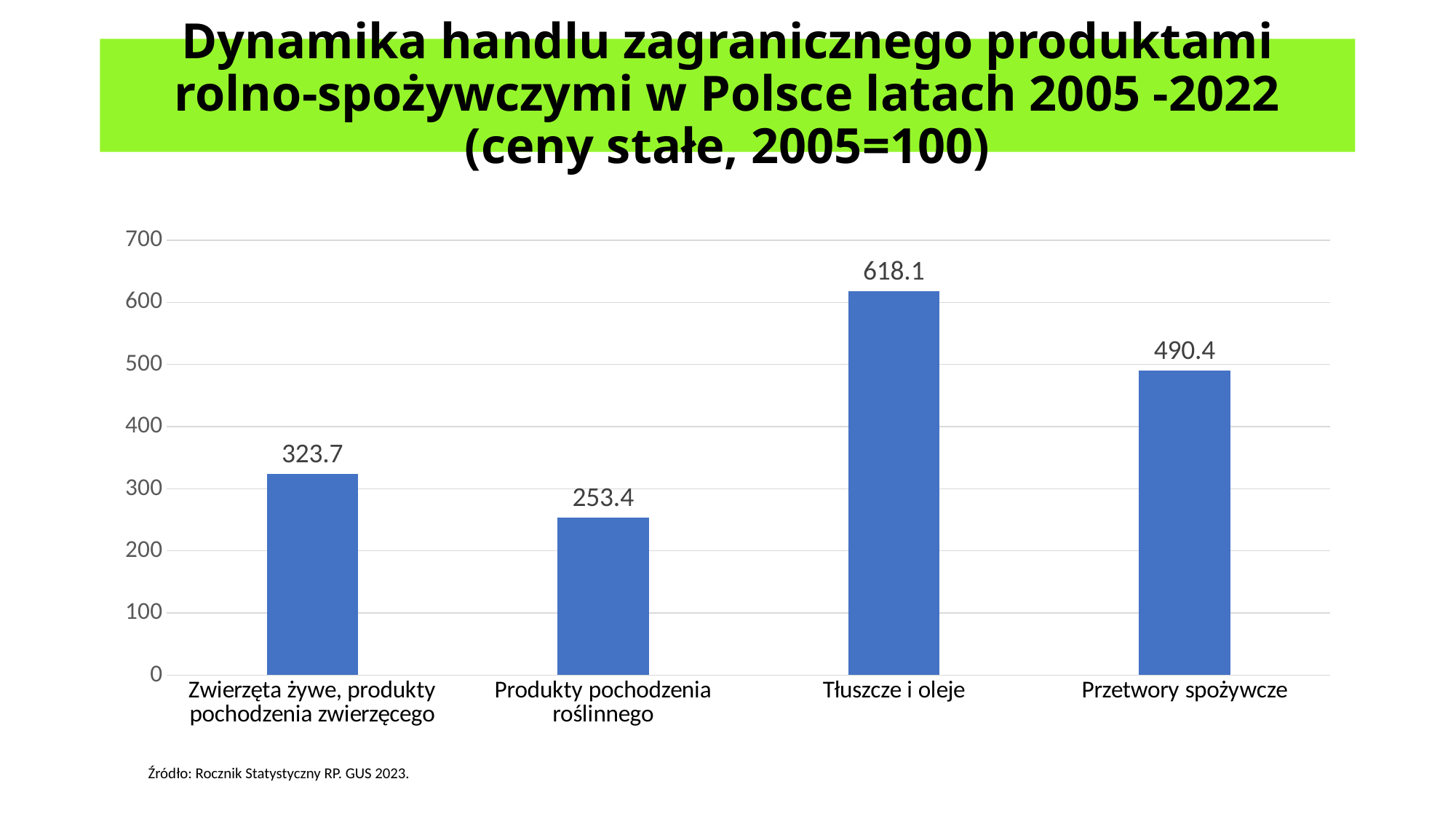
What is the difference between the values for Tłuszcze i oleje and Przetwory spożywcze? 127.7 How many categories are shown in the chart? 4 What is the value for Przetwory spożywcze? 490.4 Which is larger: the value for Przetwory spożywcze or the value for Zwierzęta żywe, produkty pochodzenia zwierzęcego? Przetwory spożywcze What is the difference between the values for Zwierzęta żywe, produkty pochodzenia zwierzęcego and Produkty pochodzenia roślinnego? 70.3 What is the value for Zwierzęta żywe, produkty pochodzenia zwierzęcego? 323.7 What is the value for Produkty pochodzenia roślinnego? 253.4 Which category has the highest value? Tłuszcze i oleje Which category has the lowest value? Produkty pochodzenia roślinnego Is the value for Przetwory spożywcze greater or less than 500? less What is the value for Tłuszcze i oleje? 618.1 What kind of chart is shown on the slide? bar chart